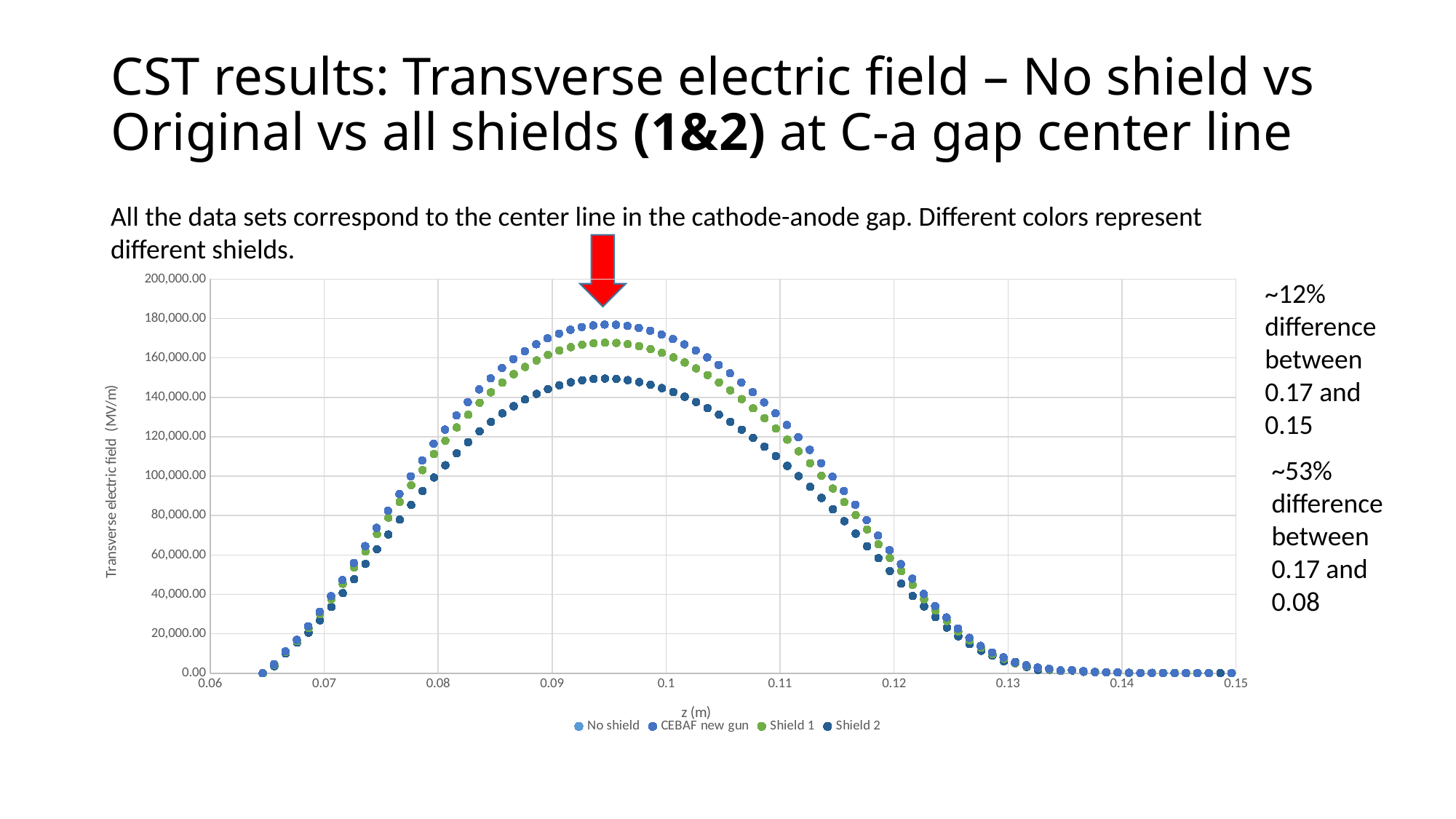
Which series has the lowest peak value on the chart? Shield 2 What kind of chart is shown on the slide? scatter chart Which series reaches a higher peak value, Shield 1 or Shield 2? Shield 1 Is the peak value of the Shield 2 series greater or less than 160,000.00? less What is the label of the y axis? Transverse electric field (MV/m) What is the label of the x axis? z (m) Is the peak value of the Shield 2 series greater or less than 140,000.00? greater Is the peak value of the No shield series greater or less than 180,000.00? less How do the values change along the x axis from 0.06 to 0.15? They rise to a peak near 0.095 and then fall How many series does the chart legend list? 4